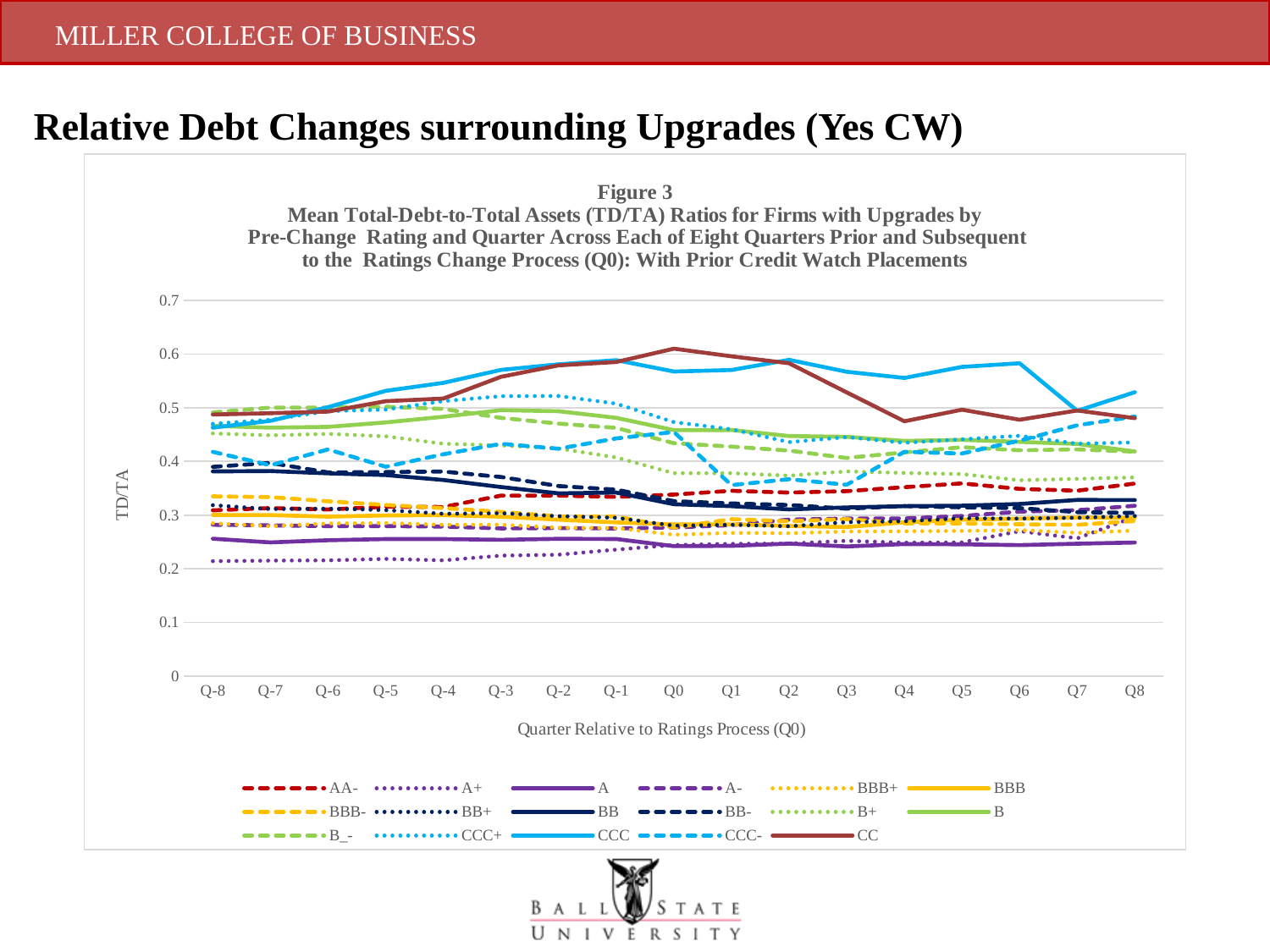
Which series has the highest value at Q0? CC Does the A+ series rise or fall from Q-8 to Q8? rise Which series has the lowest value at Q-8? A+ Is the value for A+ at Q-8 greater or less than 0.3? less How many series does the legend list? 17 What kind of chart is shown on the slide? line chart Is the value for CC at Q0 greater or less than 0.6? greater How many quarters are shown along the x axis? 17 What is the label of the y axis? TD/TA Is the value for B+ at Q-8 greater or less than 0.4? greater What is the label of the x axis? Quarter Relative to Ratings Process (Q0)